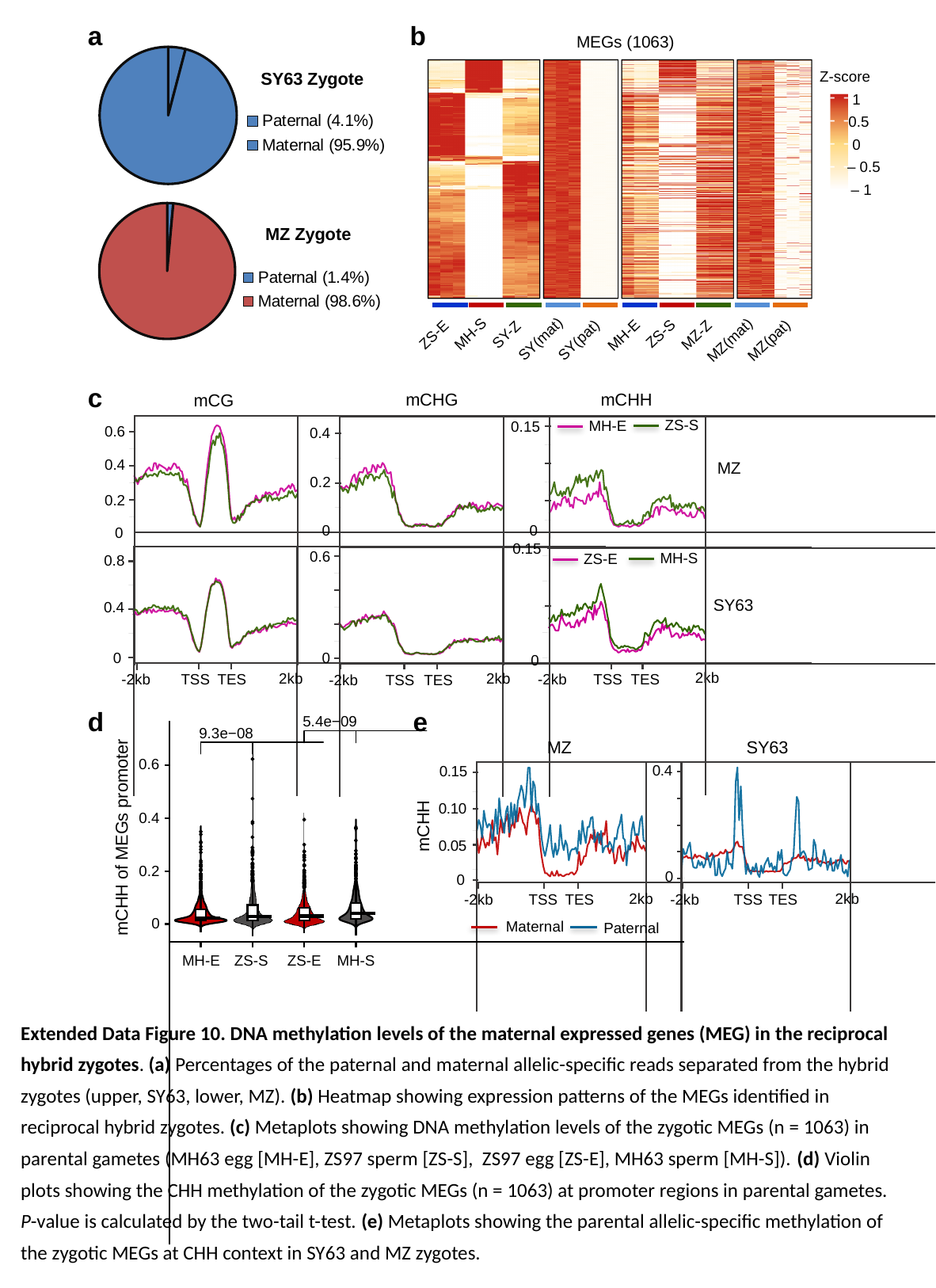
Which zygote pie chart shows the higher Paternal percentage, SY63 Zygote or MZ Zygote? SY63 Zygote In the MZ Zygote pie chart, what percentage of reads is Paternal? 1.4% What is the maximum value shown on the Z-score colour scale of the heatmap in panel b? 1 How many categories are shown on the x axis of the violin plot in panel d? 4 What type of chart is used in panel a to show the paternal and maternal read percentages? Pie chart In panel e, how many series does the legend list? 2 How many MEGs are indicated in the title of the heatmap in panel b? 1063 In the MZ Zygote pie chart, what percentage of reads is Maternal? 98.6% In the SY63 Zygote pie chart, what percentage of reads is Paternal? 4.1% How many column labels are shown beneath the heatmap in panel b? 10 What is the difference between the Maternal percentages in the MZ Zygote and SY63 Zygote pie charts? 2.7% In the SY63 Zygote pie chart, which slice is larger, Paternal or Maternal? Maternal